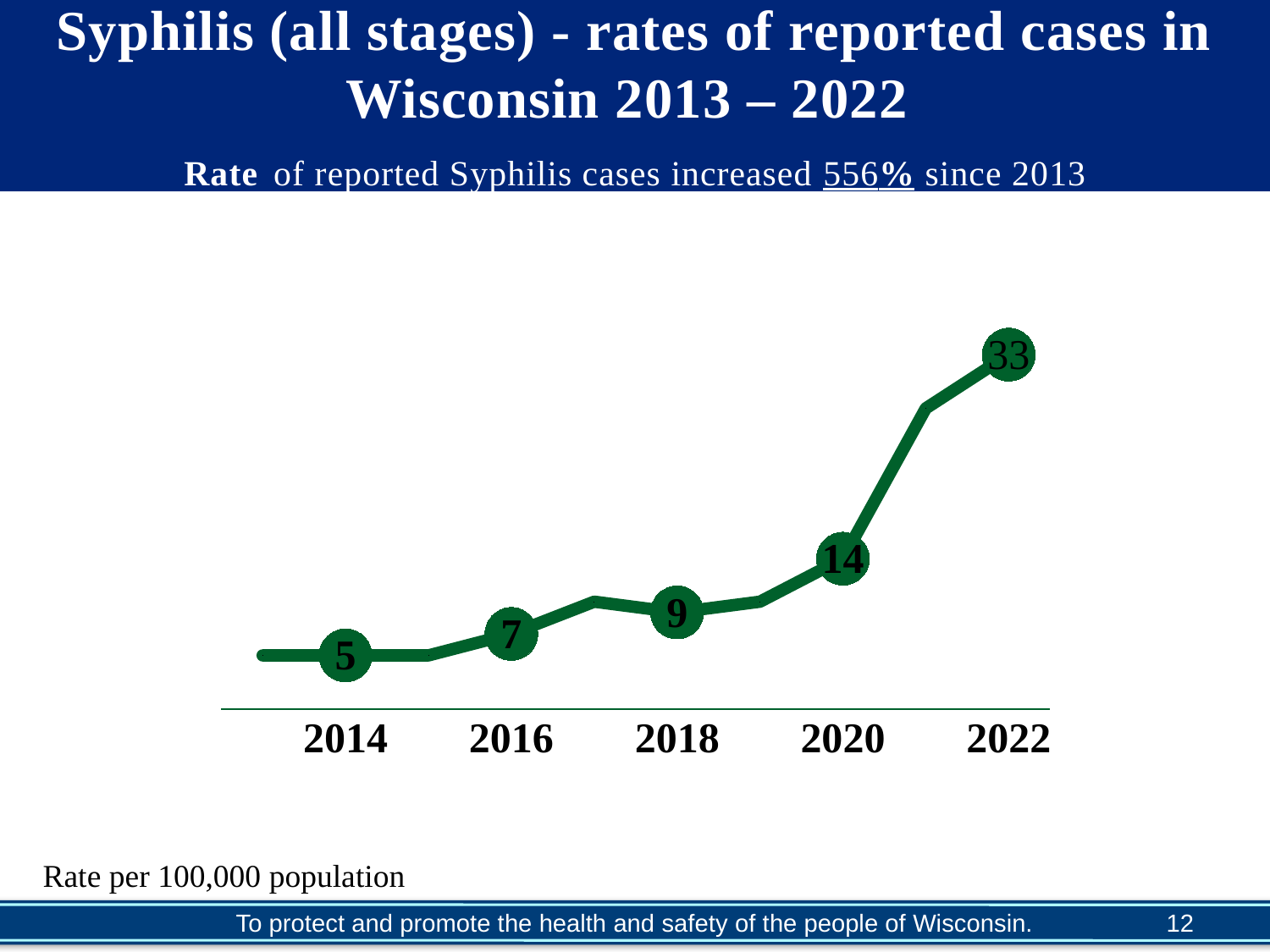
Which year has a higher rate, 2018 or 2020? 2020 What is the rate of reported syphilis cases in 2016? 7 Which year shown has the highest rate of reported syphilis cases? 2022 What is the rate of reported syphilis cases in 2022? 33 By how much did the rate increase from 2020 to 2022? 19 What kind of chart is shown on the slide? Line chart What is the difference between the rate in 2022 and the rate in 2014? 28 What is the rate of reported syphilis cases in 2018? 9 Do the rates generally rise or fall from 2013 to 2022? Rise What is the rate of reported syphilis cases in 2020? 14 What is the rate of reported syphilis cases in 2014? 5 Which labeled year has the lowest rate of reported syphilis cases? 2014